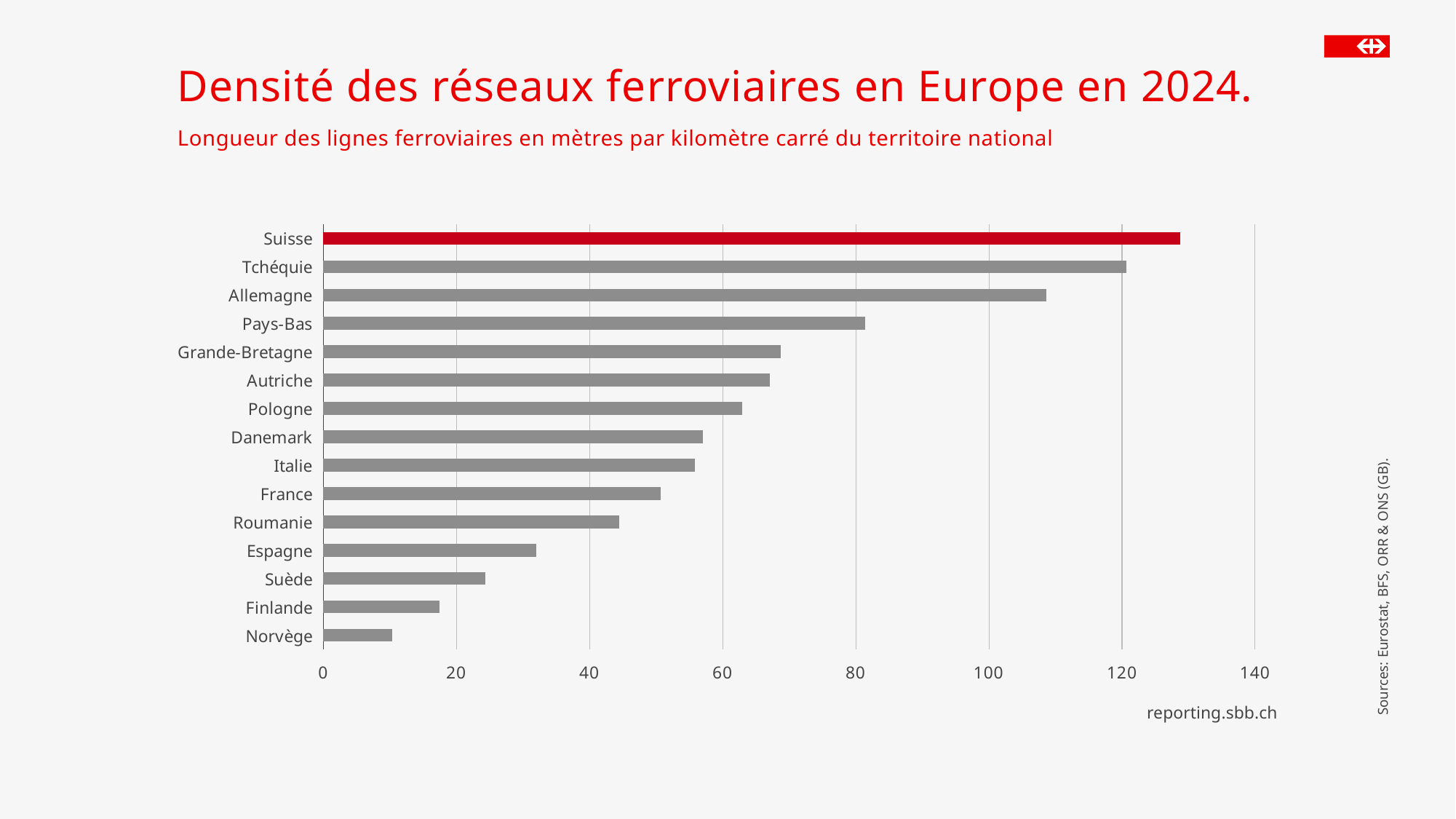
Which country has the lowest rail network density in the chart? Norvège Is the value for Allemagne greater or less than 100? greater How many countries are shown in the chart? 15 Is the value for Norvège greater or less than 20? less Is the value for Espagne greater or less than 40? less Which has a higher value, Allemagne or Pays-Bas? Allemagne Which country has the highest rail network density in the chart? Suisse Which has a higher value, Espagne or Suède? Espagne Which country's bar is highlighted in red? Suisse What kind of chart is shown on the slide? bar chart